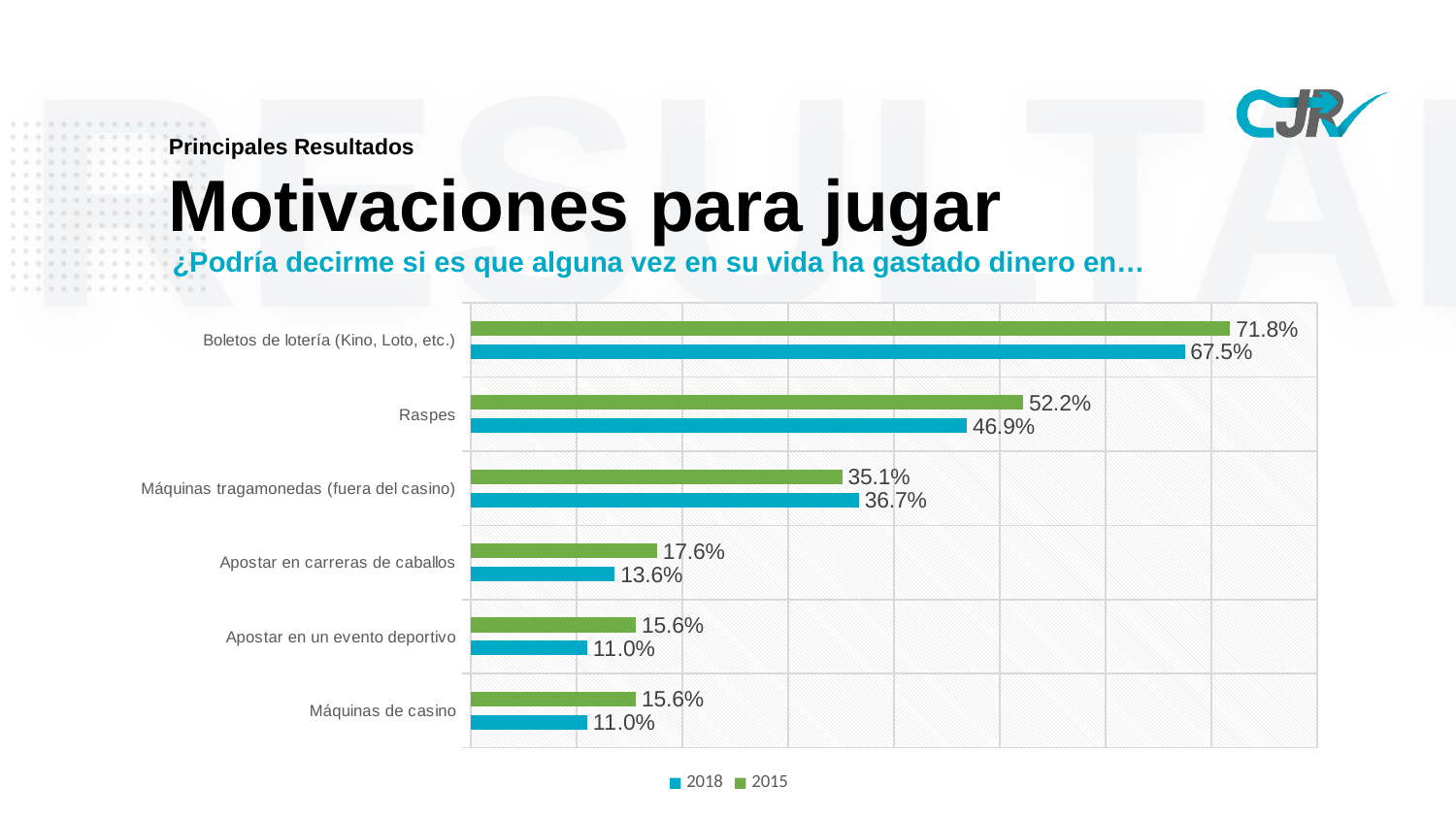
Which category has the lowest 2015 value? Apostar en un evento deportivo and Máquinas de casino (tied at 15.6%) Which category has the highest 2015 value? Boletos de lotería (Kino, Loto, etc.) How many series does the legend list? 2 For Máquinas tragamonedas (fuera del casino), which year has the larger value, 2018 or 2015? 2018 What is the difference between the 2015 and 2018 values for Raspes? 5.3% What kind of chart is shown on the slide? Bar chart What is the 2018 value for Máquinas tragamonedas (fuera del casino)? 36.7% How many categories are shown in the chart? 6 What is the 2015 value for Apostar en carreras de caballos? 17.6% What is the 2018 value for Boletos de lotería (Kino, Loto, etc.)? 67.5% What is the 2015 value for Raspes? 52.2% Which colour represents the 2018 series in the chart? Blue